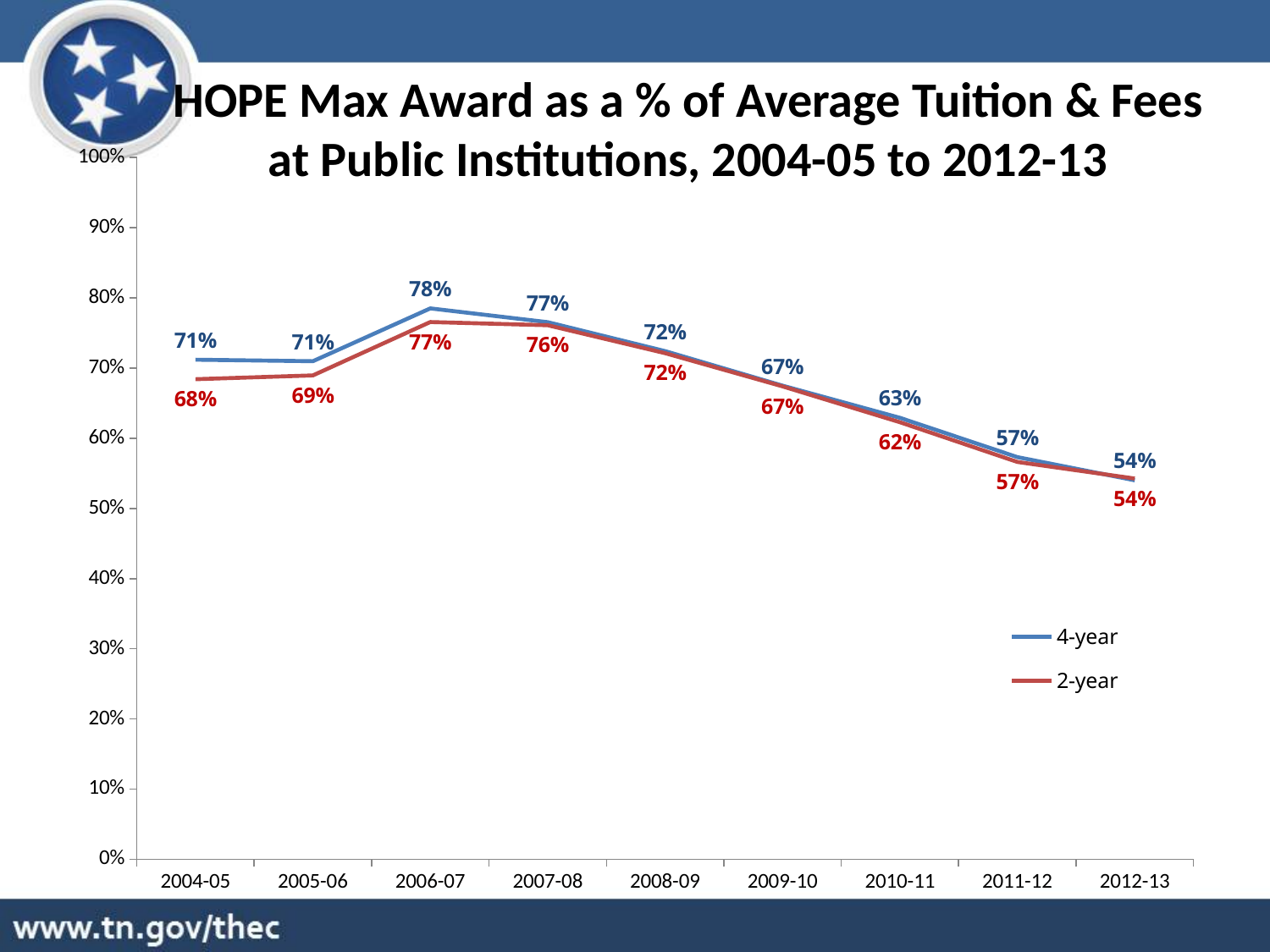
In which year is the 2-year series lowest? 2012-13 How many years are shown on the x axis? 9 How many series does the legend list? 2 What is the value for 4-year in 2006-07? 78% What colour is the 2-year line? red Do the 4-year values rise or fall from 2007-08 to 2012-13? fall What is the value for 2-year in 2004-05? 68% In which year is the 4-year series highest? 2006-07 What kind of chart is this? line chart What is the value for 2-year in 2010-11? 62% What is the difference between the 4-year and 2-year values in 2004-05? 3% Which is larger in 2005-06, the 4-year value or the 2-year value? 4-year